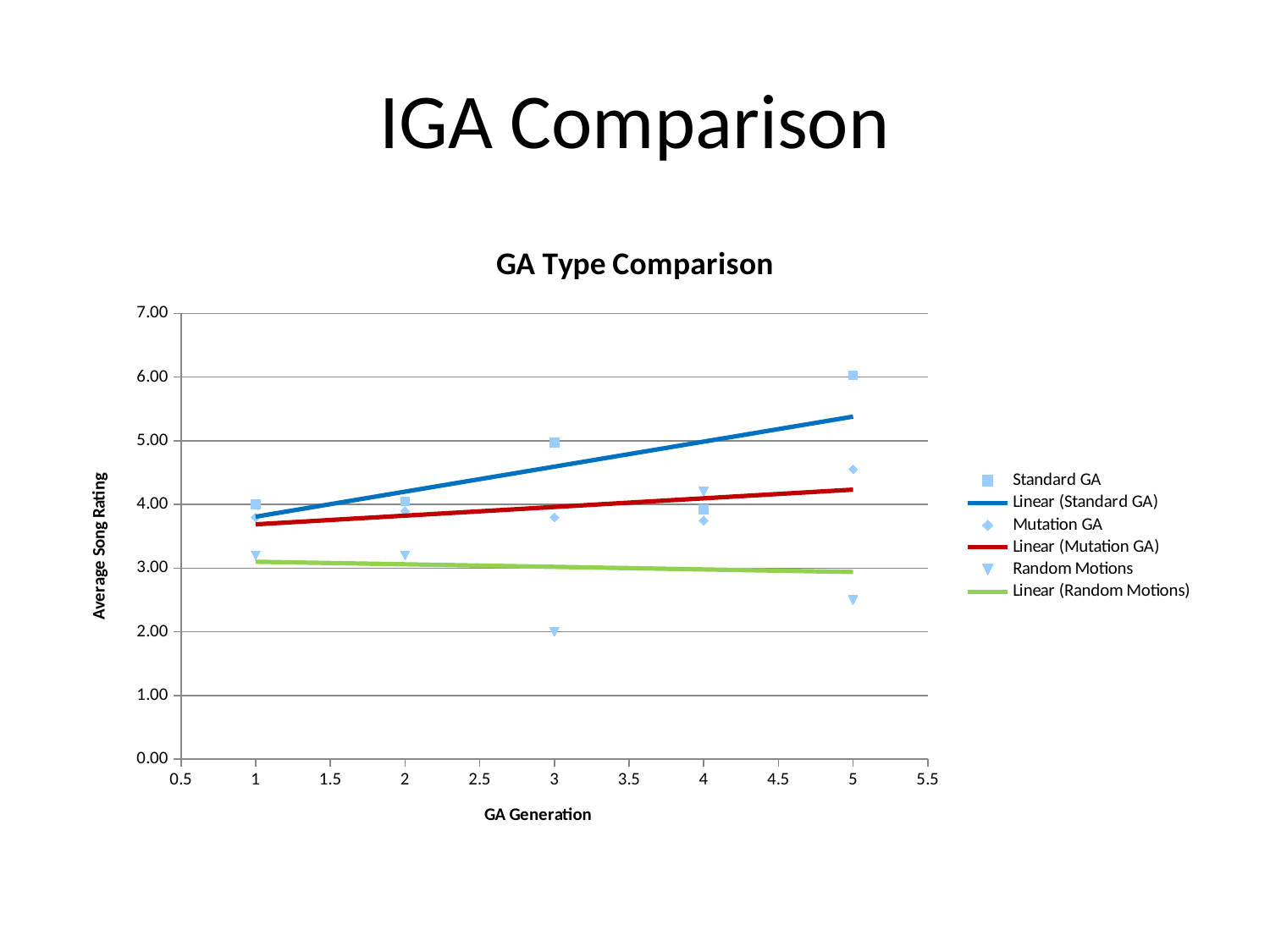
At which GA generation does the Random Motions series reach its lowest value? 3 Does the Linear (Random Motions) trend line rise or fall as GA Generation increases? fall What kind of chart is shown on the slide? Scatter chart with linear trend lines What is the title of the chart? GA Type Comparison What is the label of the vertical axis? Average Song Rating Is the Standard GA value at generation 5 greater or less than 5.00? greater How many GA generations are plotted for each series? 5 Does the Linear (Standard GA) trend line rise or fall as GA Generation increases? rise Is the Random Motions value at generation 3 greater or less than 3.00? less Is the Mutation GA value at generation 5 greater or less than 4.00? greater How many entries does the chart legend list? 6 At generation 5, which is larger: the Standard GA value or the Random Motions value? Standard GA